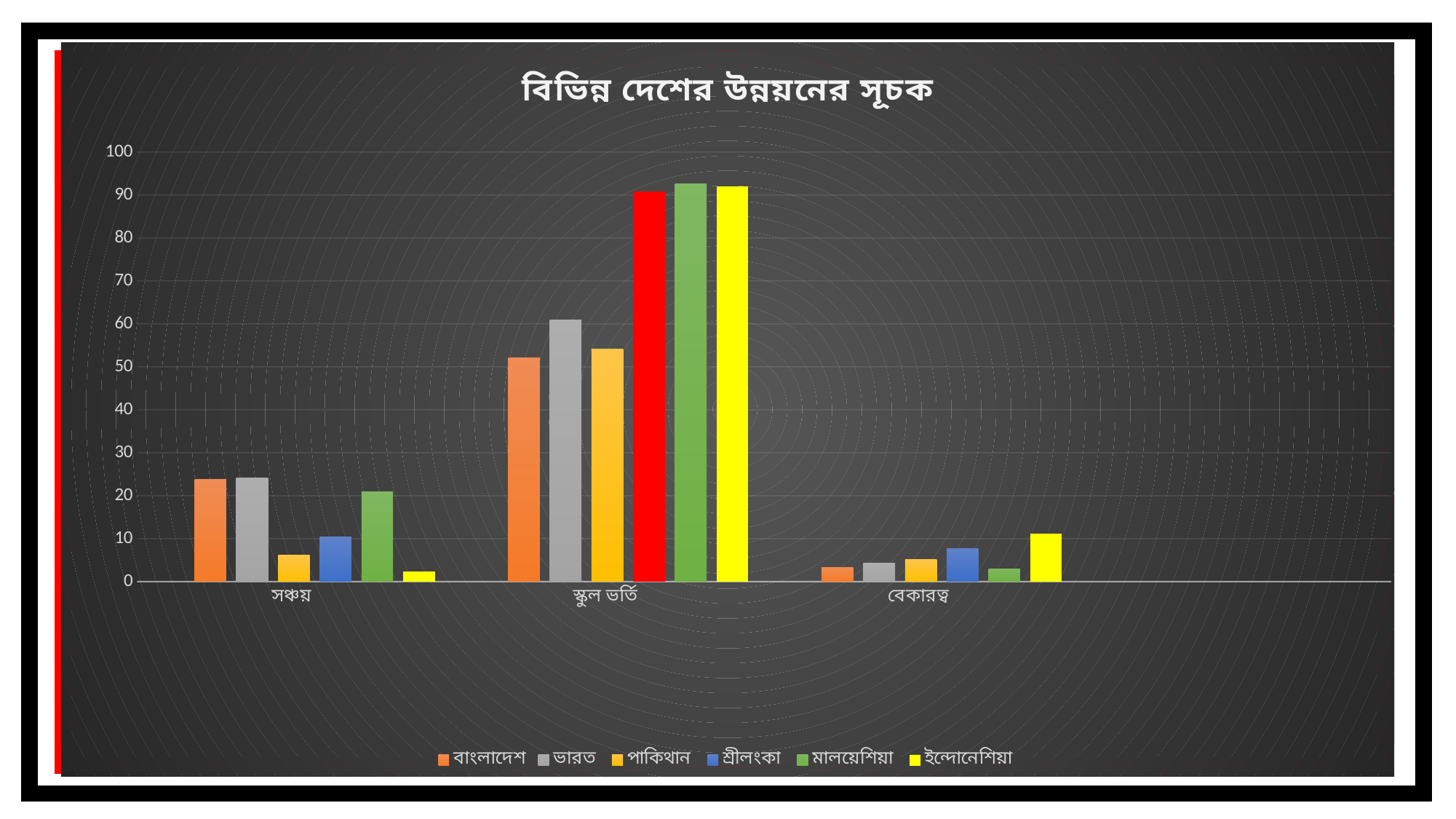
Is the value for ভারত in the স্কুল ভর্তি category greater or less than 50? greater Which series has the highest value in the বেকারত্ব category? ইন্দোনেশিয়া Which series has the lowest value in the সঞ্চয় category? ইন্দোনেশিয়া Is the value for ইন্দোনেশিয়া in the বেকারত্ব category greater or less than 20? less Is the value for মালয়েশিয়া in the স্কুল ভর্তি category greater or less than 80? greater In the সঞ্চয় category, which is larger: the value for মালয়েশিয়া or the value for ইন্দোনেশিয়া? মালয়েশিয়া What kind of chart is shown on the slide? bar chart How many series does the legend list? 6 How many categories are shown on the x axis of the chart? 3 In the স্কুল ভর্তি category, which is larger: the value for ভারত or the value for বাংলাদেশ? ভারত What is the title of the chart? বিভিন্ন দেশের উন্নয়নের সূচক